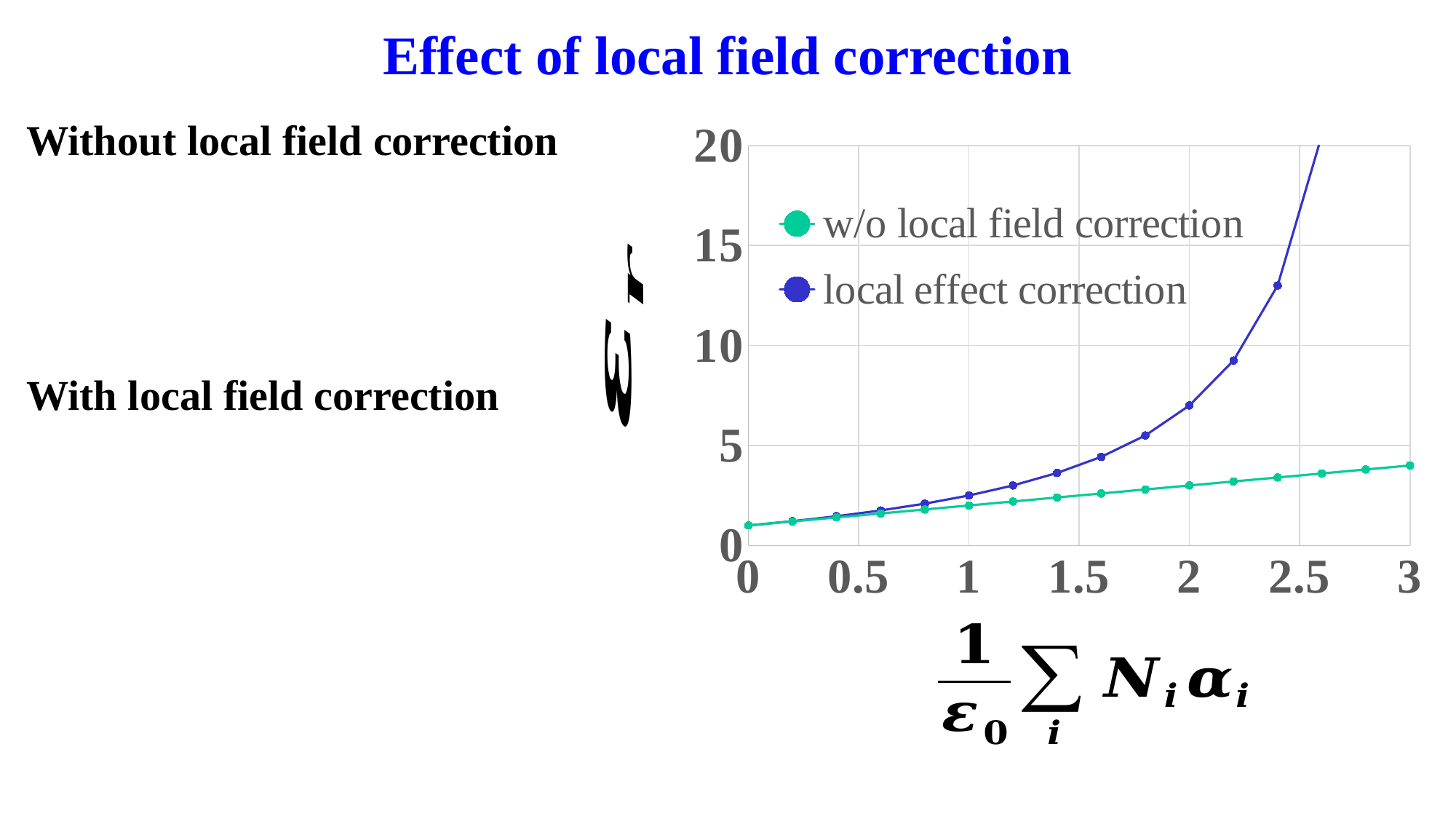
What kind of chart is shown on the slide? line chart At x = 2, which series has the larger value: 'w/o local field correction' or 'local effect correction'? local effect correction Which series reaches the highest value on the chart? local effect correction What colour is the line for the 'local effect correction' series? blue Is the value of the 'w/o local field correction' series at x = 3 greater or less than 5? less Is the value of the 'local effect correction' series at x = 2.4 greater or less than 10? greater Do the values of the 'local effect correction' series rise or fall as the x-axis value increases? rise How many series does the legend list? 2 Do the values of the 'w/o local field correction' series rise or fall as the x-axis value increases? rise What are the two series named in the legend? w/o local field correction; local effect correction Is the value of the 'w/o local field correction' series at x = 1 greater or less than 5? less